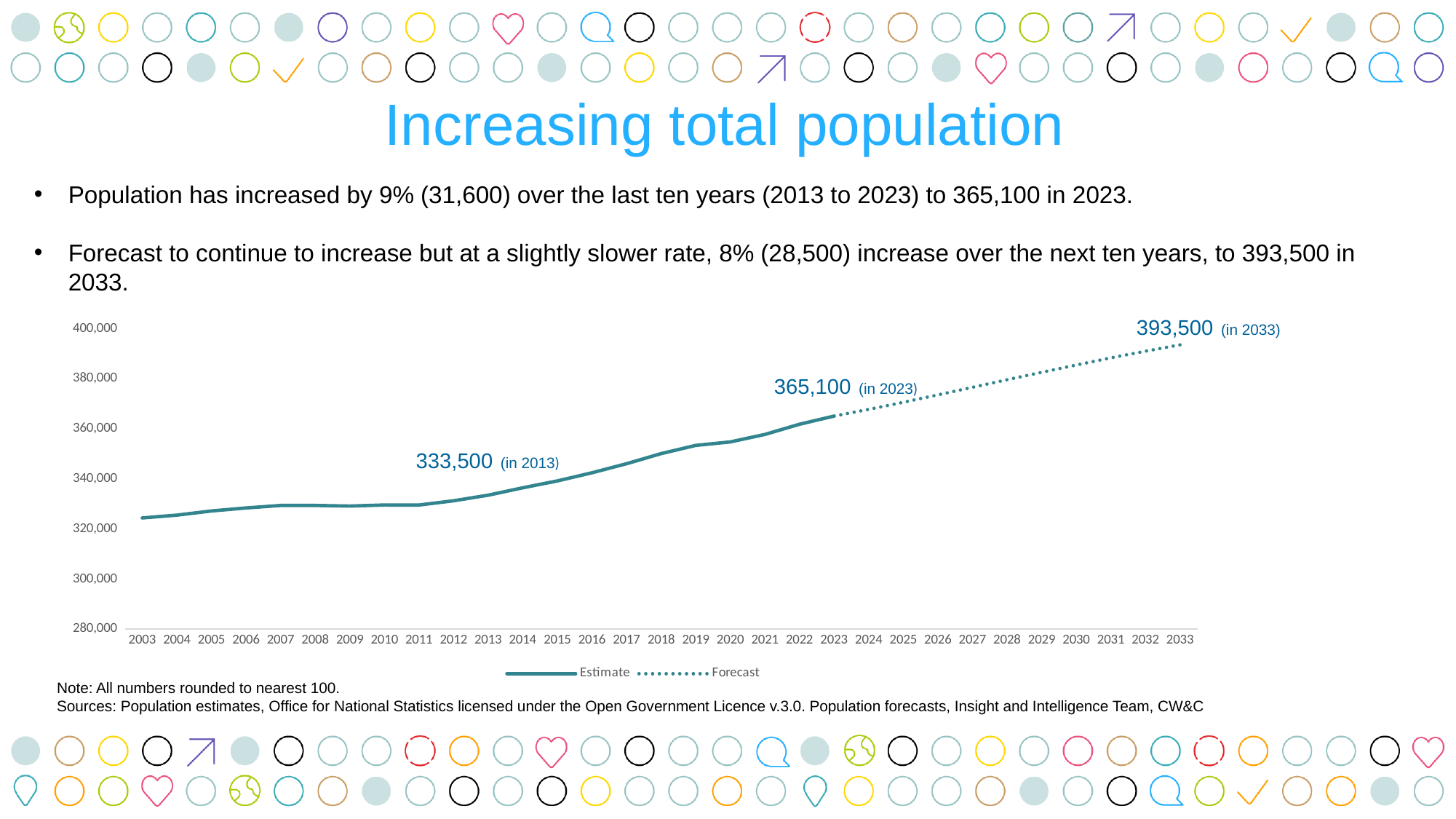
Is the forecast value for 2026 greater or less than 360,000? greater What type of chart is shown on the slide? line chart What is the forecast population value labelled for 2033? 393,500 Do the values rise or fall along the x axis from 2003 to 2033? rise What is the population value labelled for 2013? 333,500 What is the population value labelled for 2023? 365,100 Which is larger, the labelled value for 2023 or the labelled value for 2033? 2033 What is the difference between the labelled values for 2033 and 2013? 60,000 Is the value for 2019 greater or less than 340,000? greater How many series does the legend list? 2 Is the value for 2003 greater or less than 340,000? less What is the difference between the labelled values for 2023 and 2013? 31,600